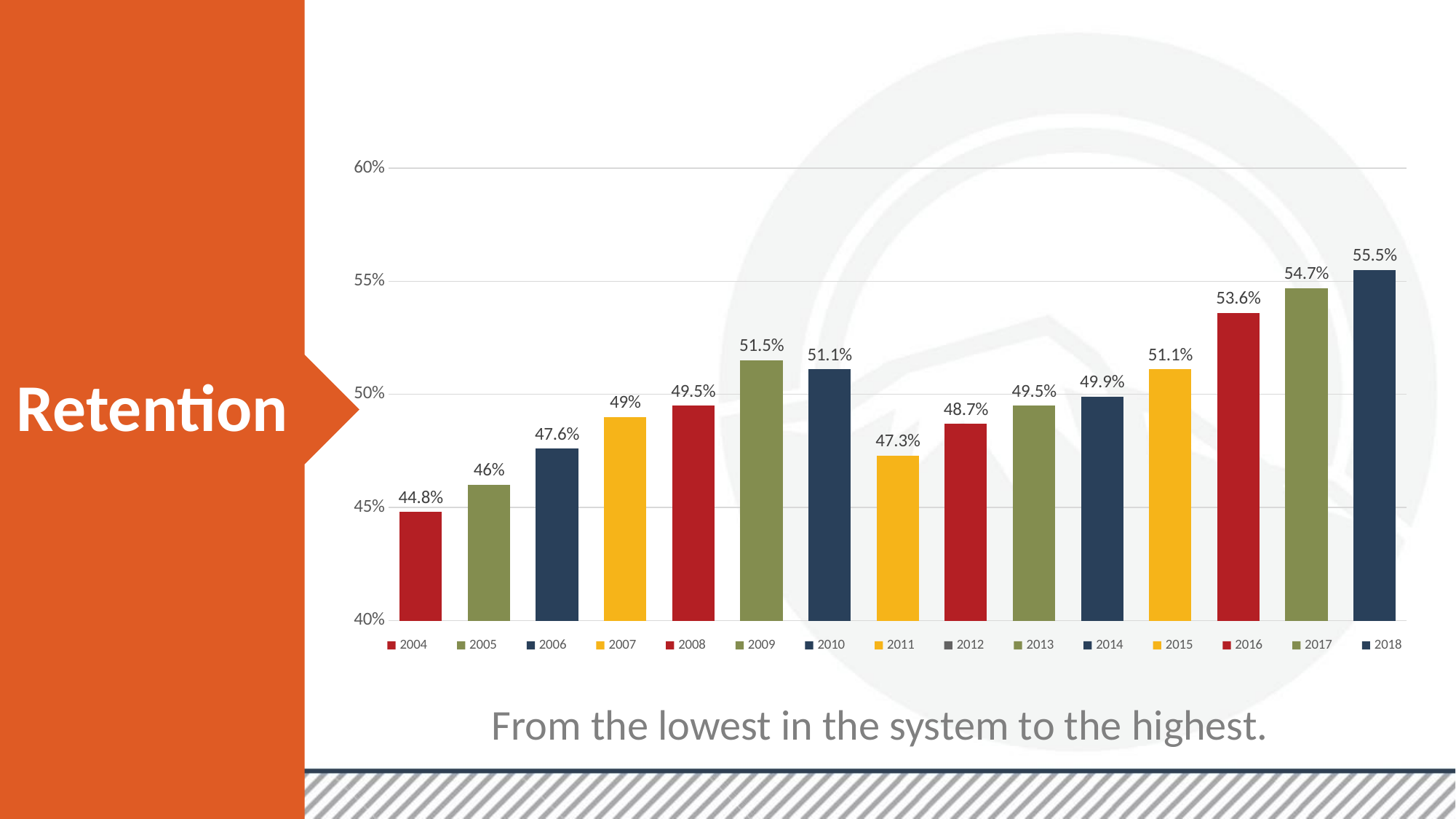
Which year has the lowest retention value? 2004 What kind of chart is shown on the slide? bar chart What is the difference between the retention values for 2018 and 2004? 10.7% Which year has the highest retention value? 2018 What is the retention value for 2011? 47.3% What is the retention value for 2018? 55.5% Which is larger, the retention value for 2016 or for 2017? 2017 Is the retention value for 2006 greater or less than 50%? less What is the retention value for 2004? 44.8% How many bars are plotted in the chart? 15 What is the retention value for 2009? 51.5% What is the caption text below the chart? From the lowest in the system to the highest.